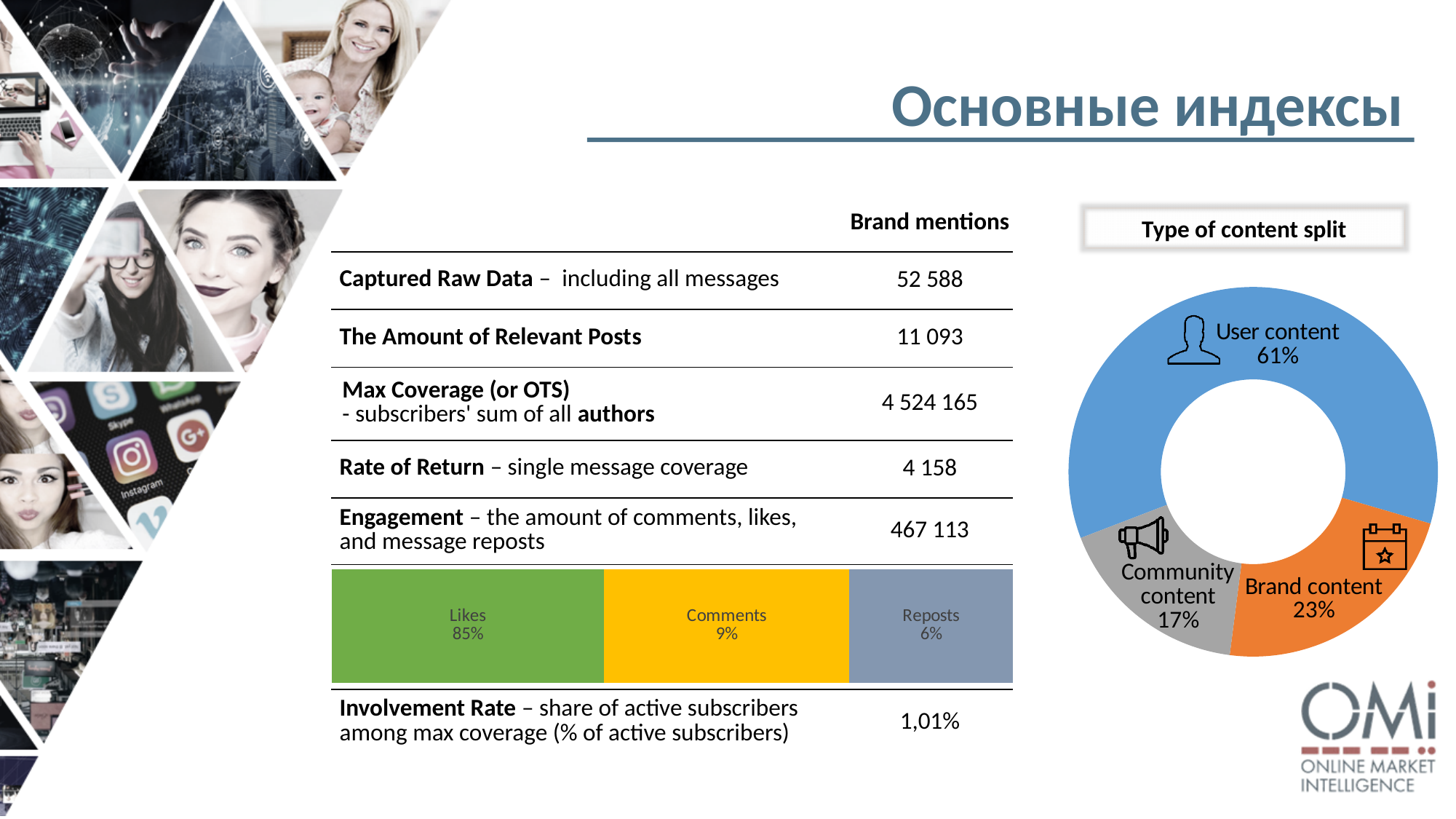
How many segments does the 'Type of content split' chart have? 3 In the 'Type of content split' chart, what is the difference in percentage points between User content and Brand content? 38 In the 'Type of content split' chart, which content type has the smallest share? Community content In the engagement split bar below the table, what share is Likes? 85% What kind of chart is 'Type of content split'? Donut (pie) chart In the 'Type of content split' chart, what share is User content? 61% In the 'Type of content split' chart, what share is Community content? 17% In the 'Type of content split' chart, which is larger: Brand content or Community content? Brand content In the 'Type of content split' chart, what colour is the User content segment? Blue In the 'Type of content split' chart, what share is Brand content? 23% In the 'Type of content split' chart, which content type has the largest share? User content In the engagement split bar below the table, what is the difference in percentage points between Comments and Reposts? 3